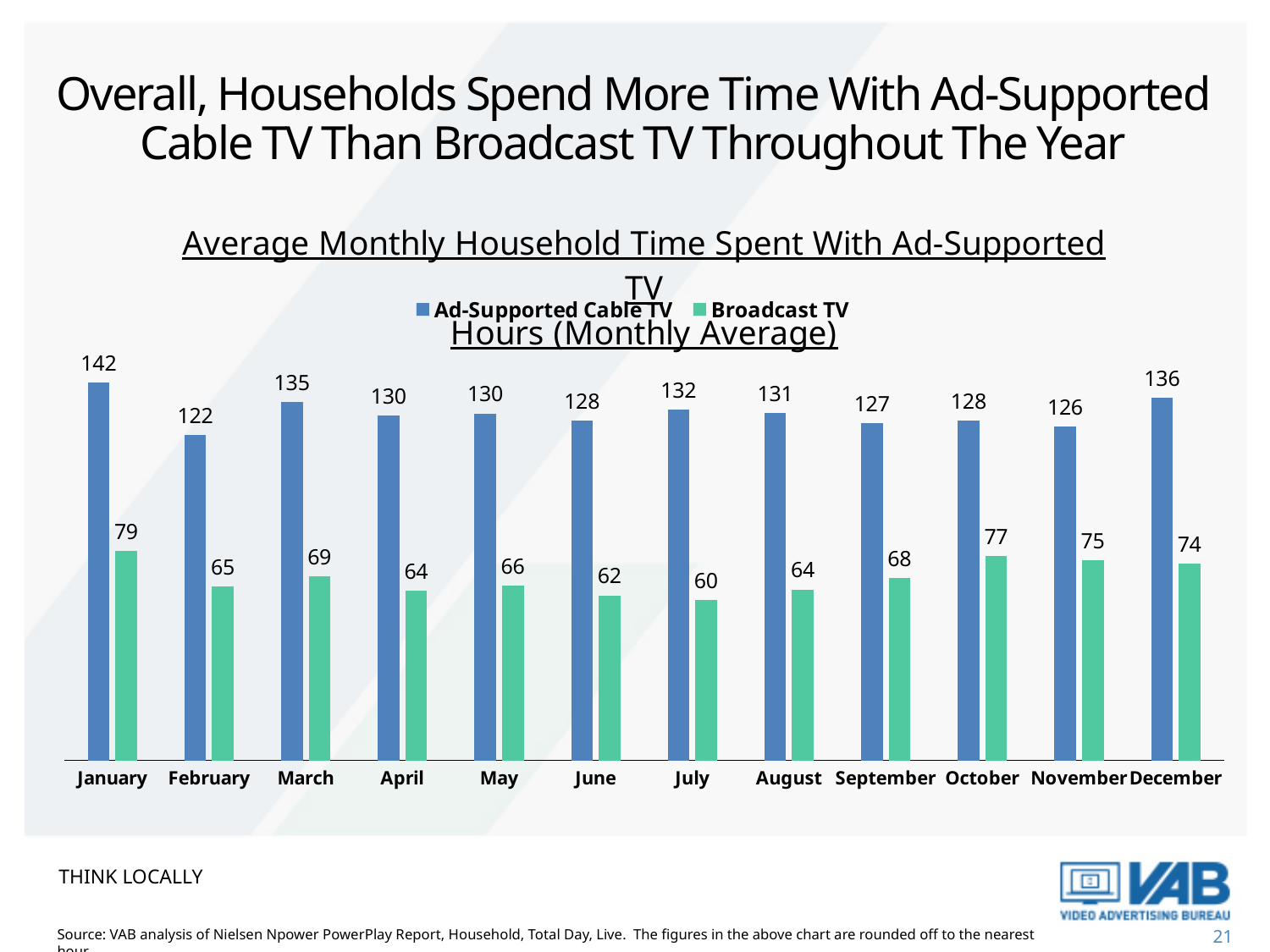
Which month has the lowest Broadcast TV value? July What is the difference between the Ad-Supported Cable TV values for December and November? 10 How many series does the legend list? 2 What is the Broadcast TV value for July? 60 What kind of chart is shown on the slide? Bar chart Which is larger, the Broadcast TV value for January or for December? January What is the Broadcast TV value for October? 77 Which month has the lowest Ad-Supported Cable TV value? February Which month has the highest Ad-Supported Cable TV value? January How many months are shown on the x axis? 12 What is the difference between the Ad-Supported Cable TV and Broadcast TV values in January? 63 What is the Ad-Supported Cable TV value for January? 142